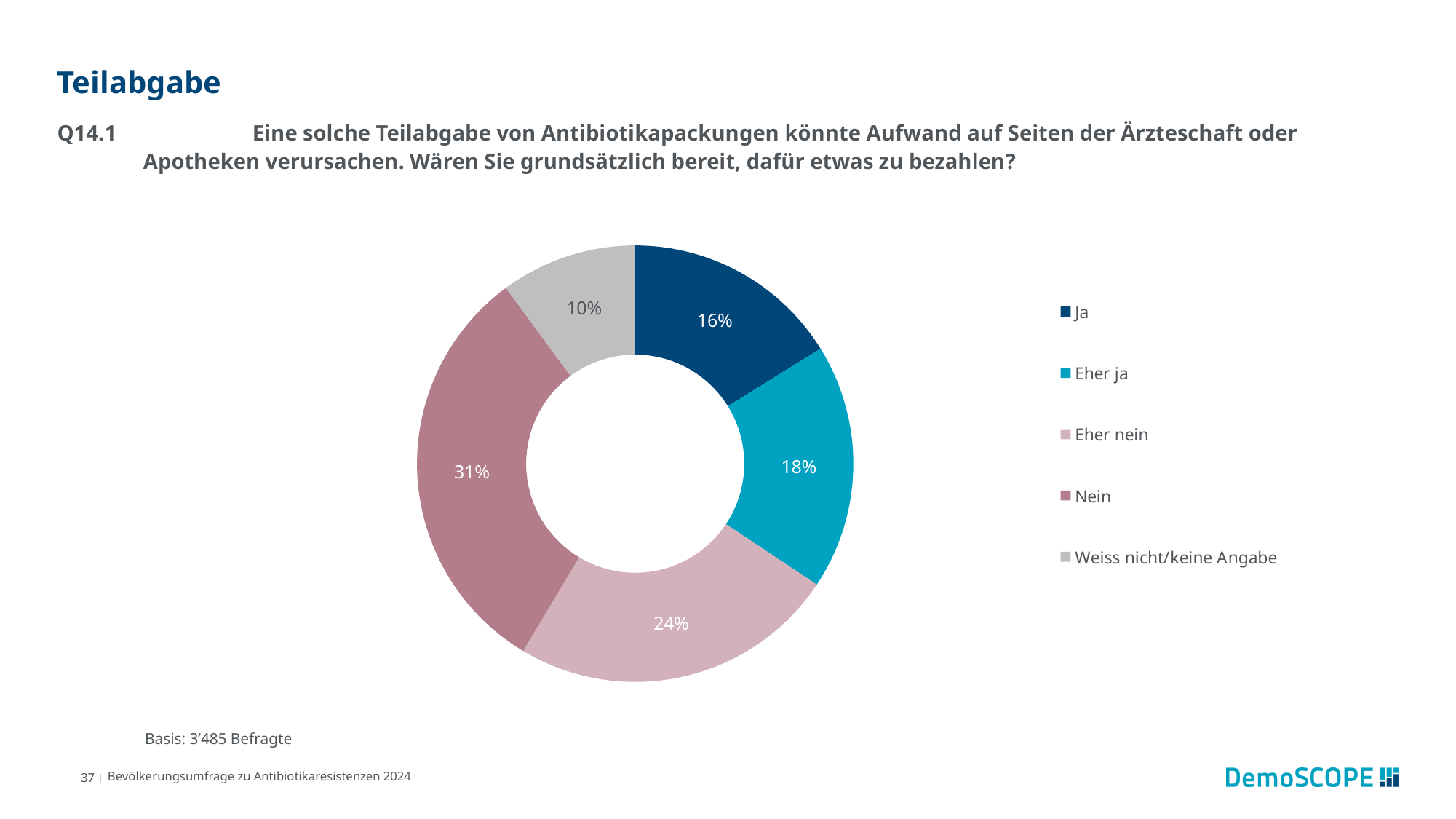
What kind of chart is shown on the slide? Doughnut chart How many answer categories are shown in the chart? 5 What percentage of respondents answered "Eher nein"? 24% Which answer category has the largest share? Nein What is the difference in percentage points between "Nein" and "Ja"? 15 What is the combined share of "Ja" and "Eher ja"? 34% What percentage of respondents answered "Ja"? 16% What percentage of respondents answered "Eher ja"? 18% What percentage of respondents answered "Weiss nicht/keine Angabe"? 10% Which answer category has the smallest share? Weiss nicht/keine Angabe What percentage of respondents answered "Nein"? 31% Which is larger, the share for "Eher nein" or the share for "Eher ja"? Eher nein